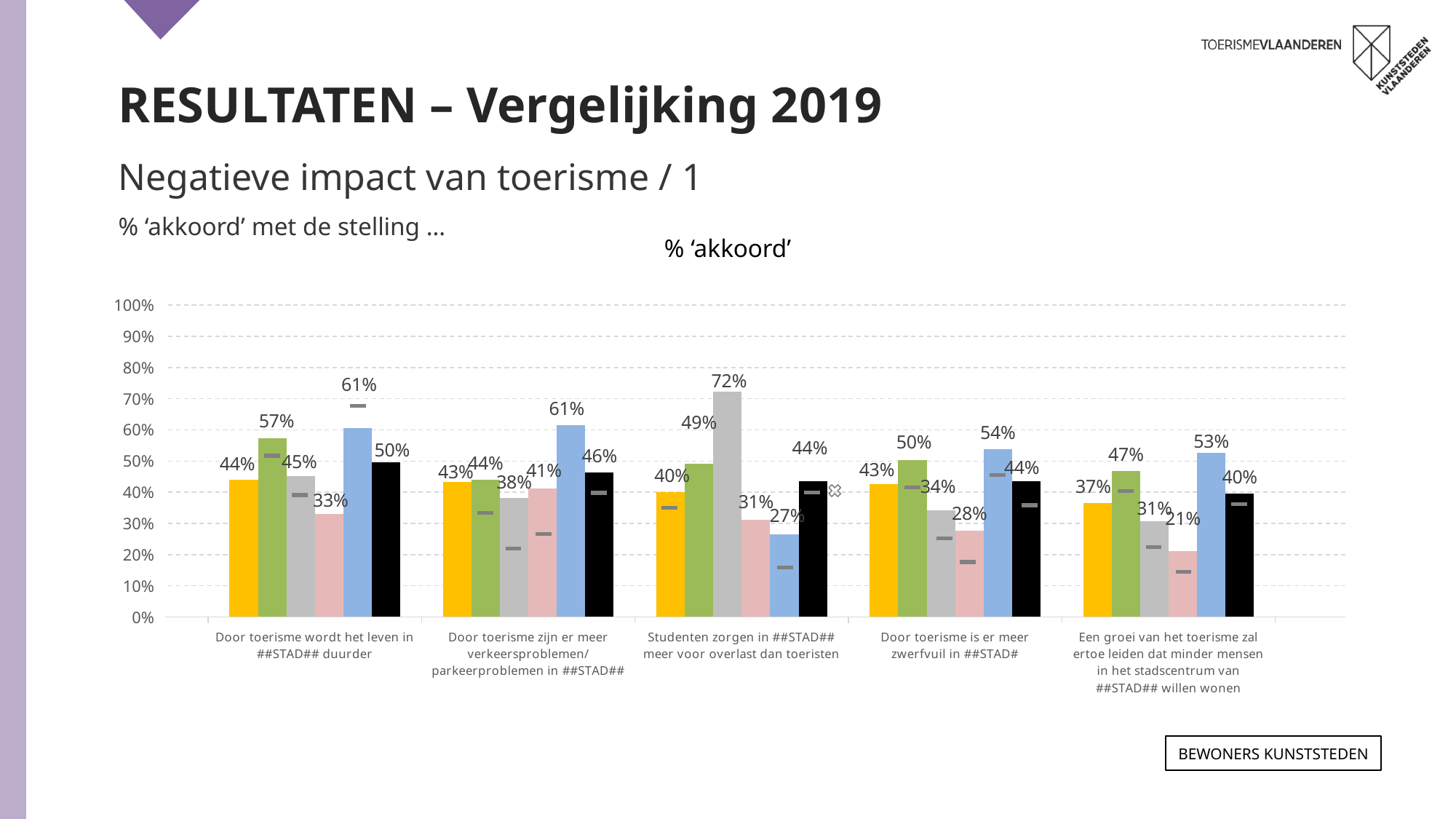
Which coloured bar is the highest for the statement 'Door toerisme zijn er meer verkeersproblemen/parkeerproblemen in ##STAD##'? blue What is the title of the chart? % ‘akkoord’ Is the value of the grey bar for the statement 'Studenten zorgen in ##STAD## meer voor overlast dan toeristen' greater or less than 70%? greater What kind of chart is shown on the slide? bar chart What is the value of the blue bar for the statement 'Door toerisme wordt het leven in ##STAD## duurder'? 61% What is the difference between the green bar and the pink bar for the statement 'Door toerisme wordt het leven in ##STAD## duurder'? 24% Which is larger for the statement 'Door toerisme is er meer zwerfvuil in ##STAD#': the yellow bar or the green bar? green bar What is the value of the black bar for the statement 'Door toerisme is er meer zwerfvuil in ##STAD#'? 44% What is the value of the pink bar for the statement 'Een groei van het toerisme zal ertoe leiden dat minder mensen in het stadscentrum van ##STAD## willen wonen'? 21% How many statement categories are shown along the x axis of the chart? 5 What is the value of the grey bar for the statement 'Studenten zorgen in ##STAD## meer voor overlast dan toeristen'? 72% Which coloured bar is the lowest for the statement 'Studenten zorgen in ##STAD## meer voor overlast dan toeristen'? blue